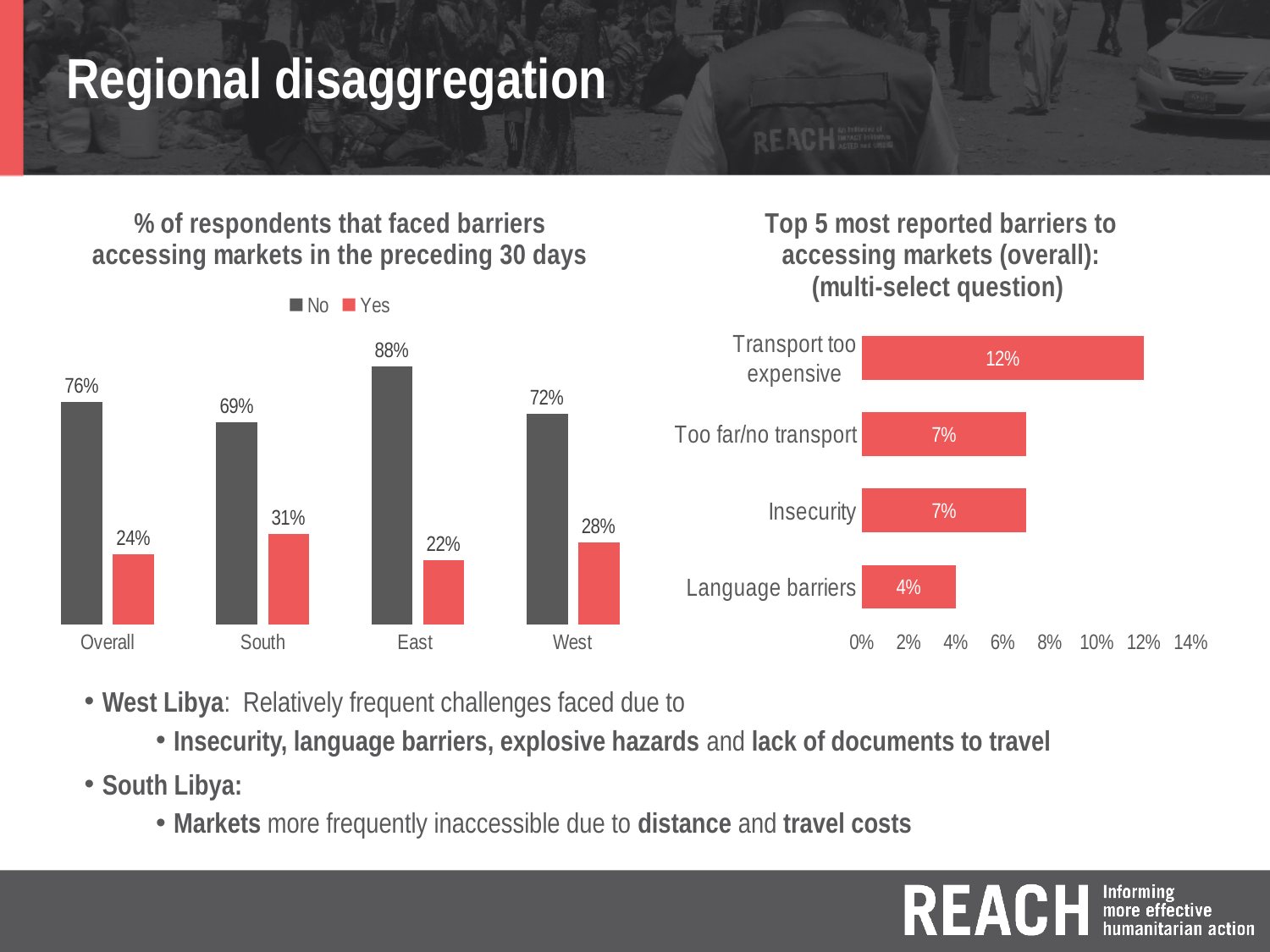
In the chart '% of respondents that faced barriers accessing markets in the preceding 30 days', what is the 'No' value for East? 88% In the chart 'Top 5 most reported barriers to accessing markets (overall)', which barrier has the lowest value? Language barriers In the chart '% of respondents that faced barriers accessing markets in the preceding 30 days', which region has the lowest 'Yes' value? East In the chart '% of respondents that faced barriers accessing markets in the preceding 30 days', which region has the highest 'Yes' value? South In the chart '% of respondents that faced barriers accessing markets in the preceding 30 days', what is the 'Yes' value for South? 31% In the chart '% of respondents that faced barriers accessing markets in the preceding 30 days', how many series does the legend list? 2 In the chart 'Top 5 most reported barriers to accessing markets (overall)', what is the value for 'Transport too expensive'? 12% What kind of chart is 'Top 5 most reported barriers to accessing markets (overall)'? Bar chart In the chart '% of respondents that faced barriers accessing markets in the preceding 30 days', how many regional categories are shown on the x axis? 4 In the chart '% of respondents that faced barriers accessing markets in the preceding 30 days', what is the difference between the 'No' and 'Yes' values for Overall? 52% In the chart 'Top 5 most reported barriers to accessing markets (overall)', what is the difference between 'Transport too expensive' and 'Language barriers'? 8% In the chart '% of respondents that faced barriers accessing markets in the preceding 30 days', which colour represents the 'Yes' series? Red